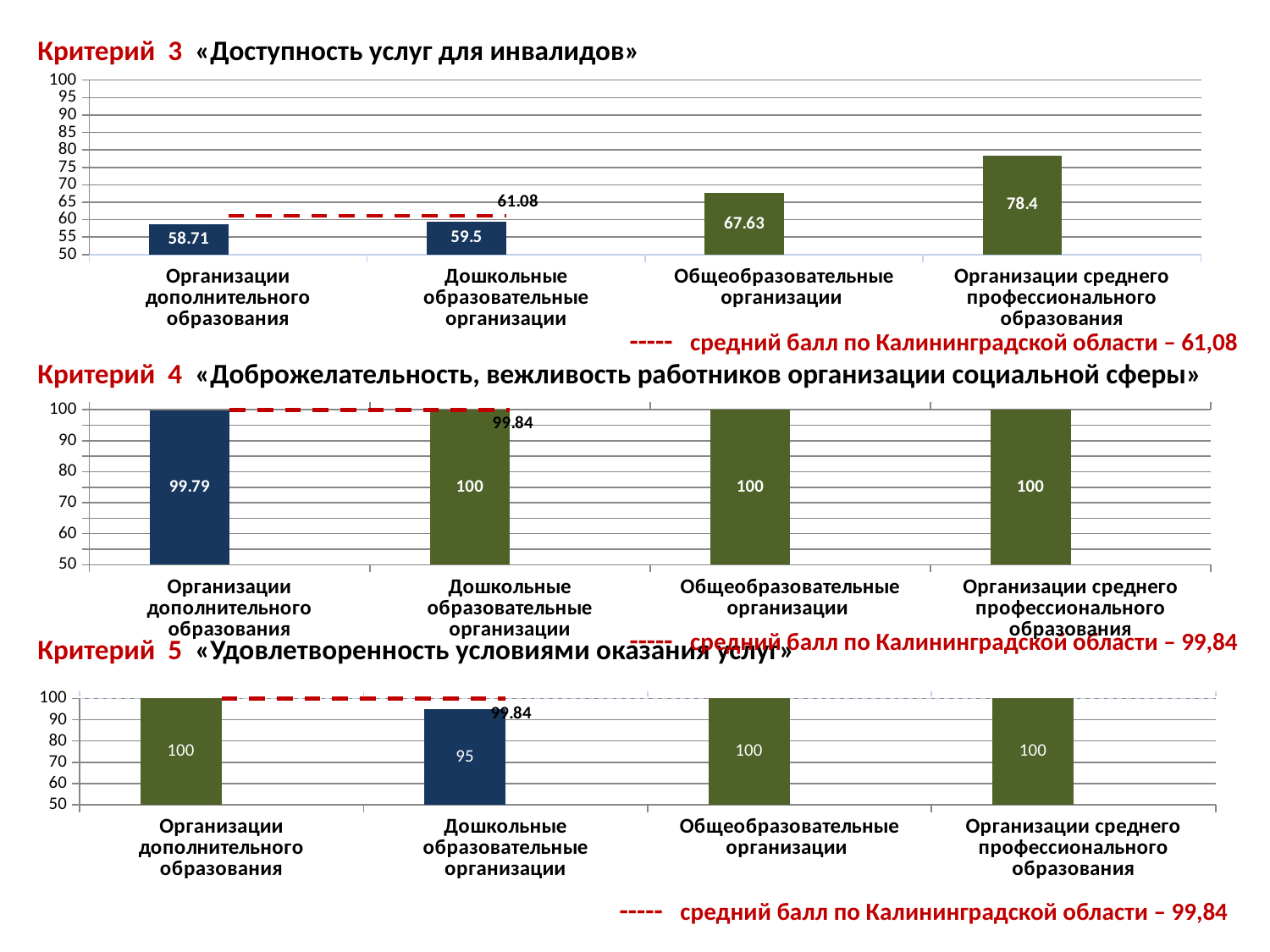
In the chart «Доступность услуг для инвалидов» (Критерий 3), what is the value for Организации среднего профессионального образования? 78.4 In the chart «Доброжелательность, вежливость работников организации социальной сферы» (Критерий 4), what is the value for Организации дополнительного образования? 99.79 In the chart «Удовлетворенность условиями оказания услуг» (Критерий 5), which is larger: the value for Организации дополнительного образования or Дошкольные образовательные организации? Организации дополнительного образования In the chart «Доступность услуг для инвалидов» (Критерий 3), what is the difference between Организации среднего профессионального образования and Общеобразовательные организации? 10.77 In the chart «Доброжелательность, вежливость работников организации социальной сферы» (Критерий 4), how many categories are shown? 4 In the chart «Доступность услуг для инвалидов» (Критерий 3), is the value for Общеобразовательные организации greater or less than 65? greater In the chart «Удовлетворенность условиями оказания услуг» (Критерий 5), which category has the lowest value? Дошкольные образовательные организации In the chart «Доступность услуг для инвалидов» (Критерий 3), which category has the highest value? Организации среднего профессионального образования In the chart «Доступность услуг для инвалидов» (Критерий 3), what is the average score for Калининградская область shown by the dashed line? 61,08 What type of chart is used for Критерий 5 «Удовлетворенность условиями оказания услуг»? bar chart In the chart «Удовлетворенность условиями оказания услуг» (Критерий 5), what is the value for Дошкольные образовательные организации? 95 In the chart «Доступность услуг для инвалидов» (Критерий 3), which category has the lowest value? Организации дополнительного образования